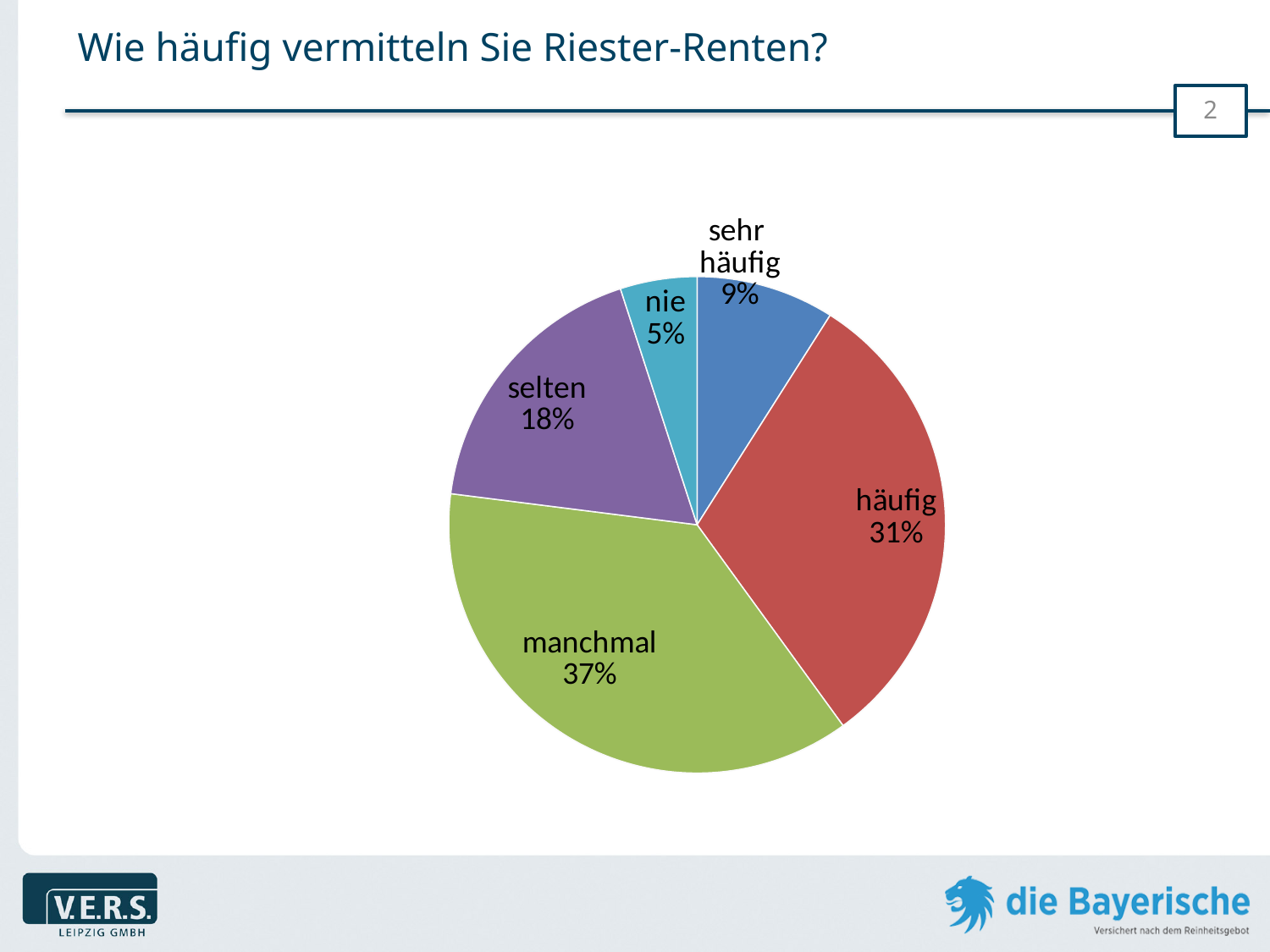
What is the value shown for "nie"? 5% What is the value shown for "sehr häufig"? 9% Which category has the largest slice of the pie? manchmal What is the difference in percentage points between "manchmal" and "häufig"? 6 What is the value shown for "häufig"? 31% Which is larger, the slice for "selten" or the slice for "sehr häufig"? selten Which category has the smallest slice of the pie? nie What kind of chart is shown on the slide? pie chart What is the value shown for "selten"? 18% What is the title of the slide containing the pie chart? Wie häufig vermitteln Sie Riester-Renten? How many slices does the pie chart have? 5 What share of the pie does "manchmal" have? 37%